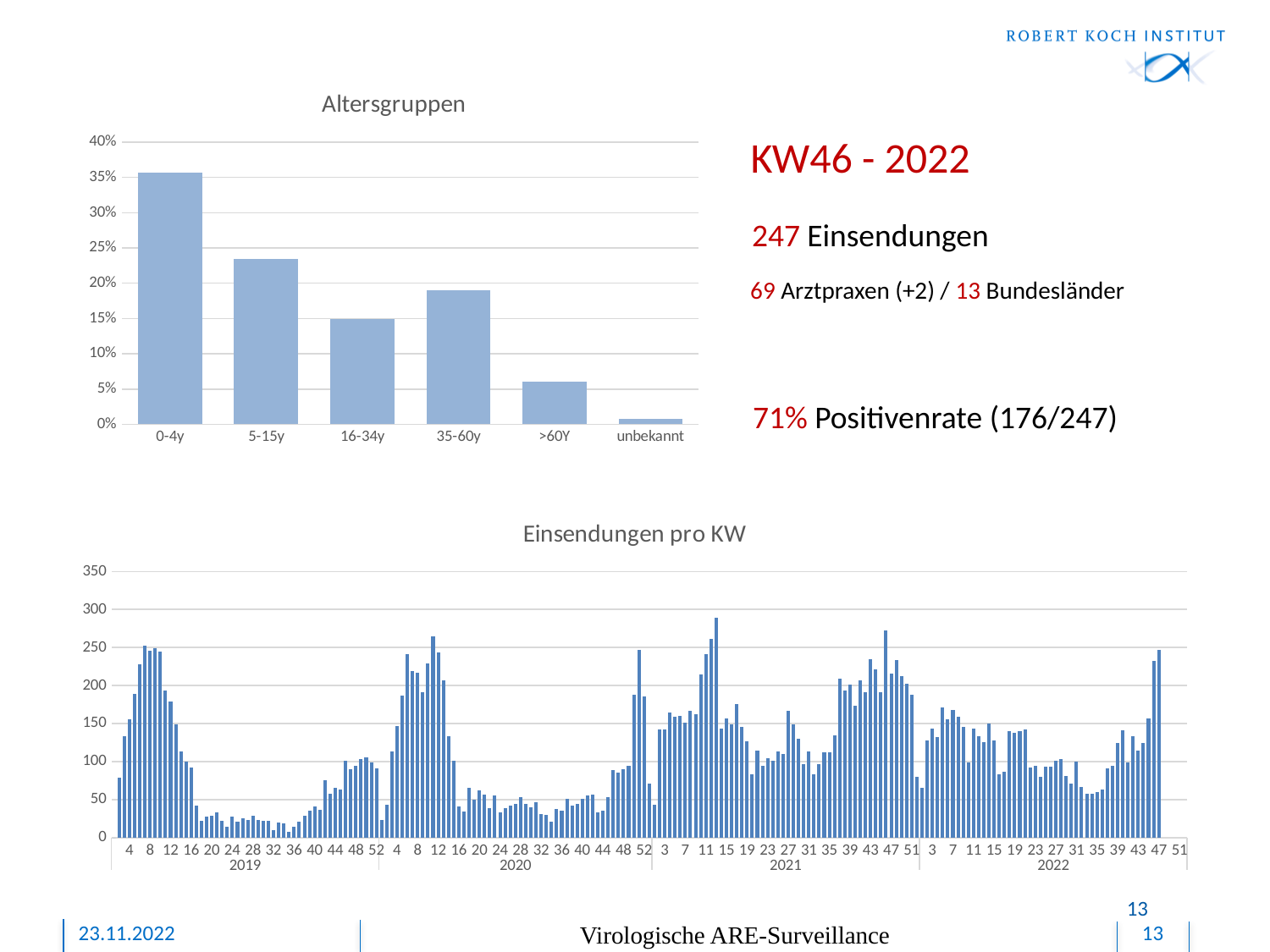
In the Altersgruppen chart, which age group has the highest value? 0-4y In the Einsendungen pro KW chart, in which year does the highest bar occur? 2021 How many age-group categories are shown in the Altersgruppen chart? 6 What is the title of the lower chart on the slide? Einsendungen pro KW In the Altersgruppen chart, is the value for 16-34y greater or less than 20%? less In the Altersgruppen chart, is the value for 0-4y greater or less than 30%? greater In the Altersgruppen chart, which is larger: the value for 5-15y or the value for 35-60y? 5-15y What kind of chart is the Altersgruppen chart? bar chart In the Einsendungen pro KW chart, is the highest bar greater or less than 250? greater How many years are labelled on the x axis of the Einsendungen pro KW chart? 4 In the Altersgruppen chart, which category has the lowest value? unbekannt